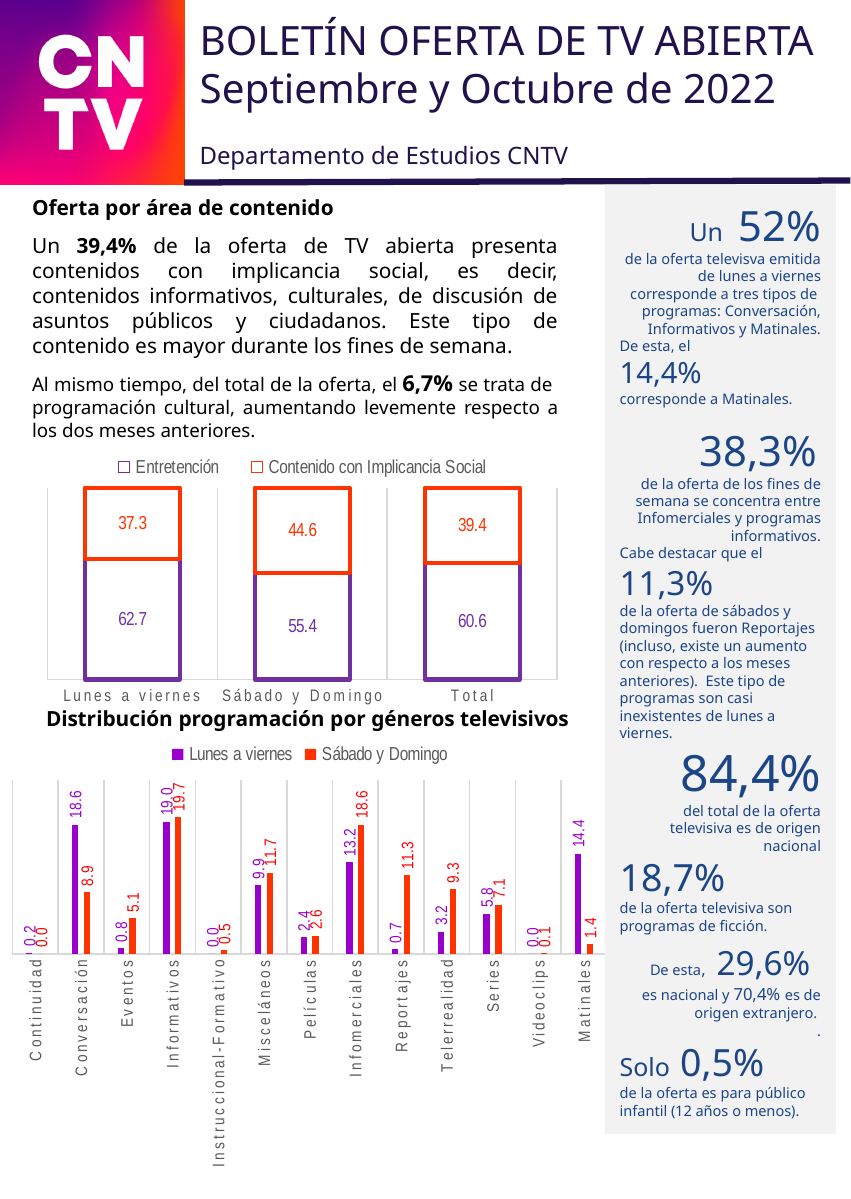
In the stacked bar chart at the top, how many series does the legend list? 2 In the chart 'Distribución programación por géneros televisivos', what is the difference between the Sábado y Domingo and Lunes a viernes values for Infomerciales? 5.4 In the stacked bar chart at the top, what is the value of Contenido con Implicancia Social for Sábado y Domingo? 44.6 In the stacked bar chart at the top, what is the value of Entretención for Lunes a viernes? 62.7 In the chart 'Distribución programación por géneros televisivos', what is the Lunes a viernes value for Conversación? 18.6 What kind of chart is 'Distribución programación por géneros televisivos'? Bar chart In the chart 'Distribución programación por géneros televisivos', which is larger for Matinales: Lunes a viernes or Sábado y Domingo? Lunes a viernes In the chart 'Distribución programación por géneros televisivos', what is the Sábado y Domingo value for Reportajes? 11.3 In the chart 'Distribución programación por géneros televisivos', how many categories are shown on the x axis? 13 In the stacked bar chart at the top, what is the difference between Entretención for Lunes a viernes and Entretención for Sábado y Domingo? 7.3 In the chart 'Distribución programación por géneros televisivos', which category has the highest Sábado y Domingo value? Informativos In the stacked bar chart at the top, what is the total of the Total bar (Entretención plus Contenido con Implicancia Social)? 100